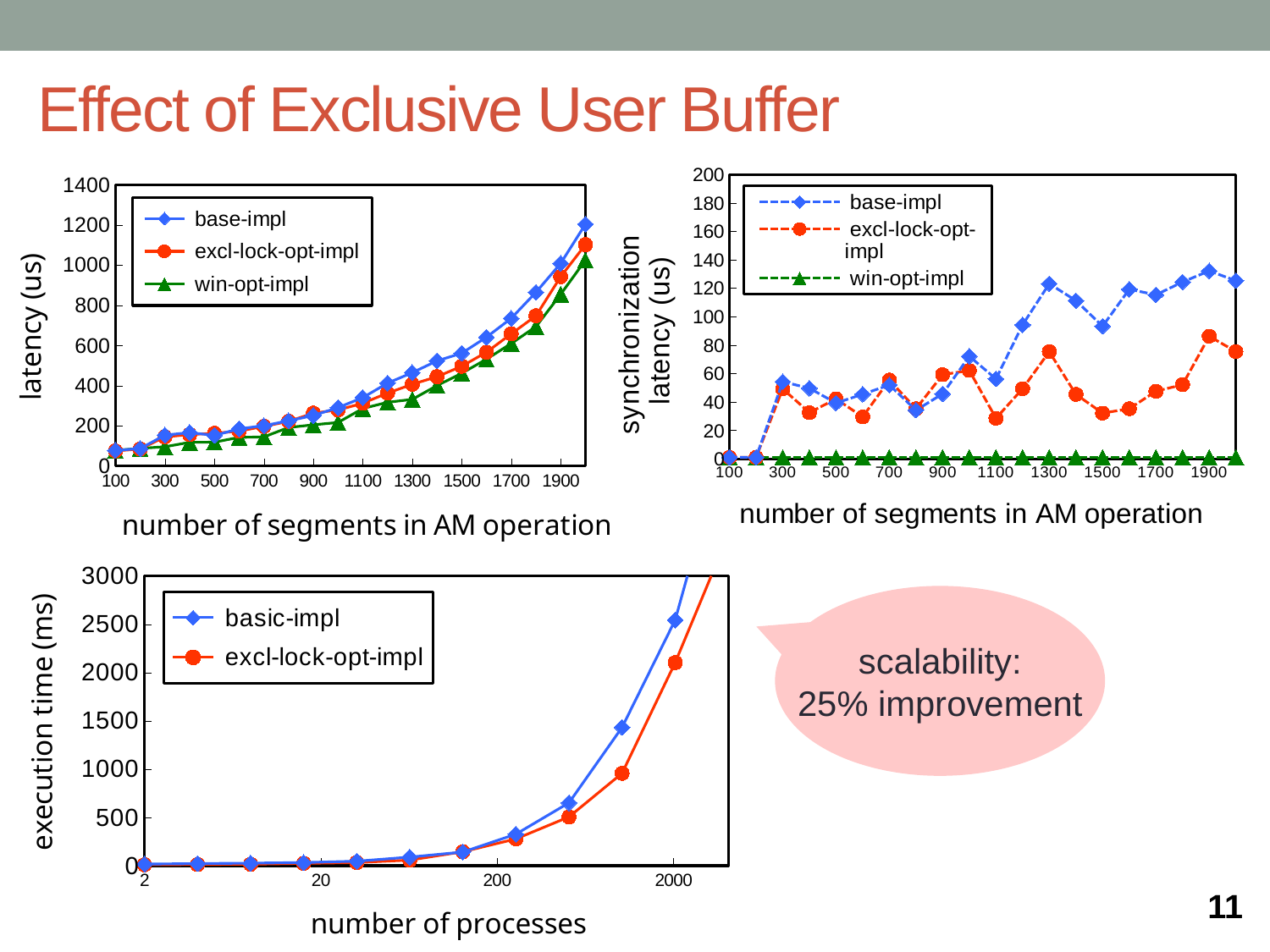
In the top-left chart (latency vs number of segments), do the latency values rise or fall as the number of segments increases? rise In the top-left chart (latency vs number of segments), what kind of chart is shown? line chart In the top-right chart (synchronization latency), which is larger at 1300 segments, base-impl or excl-lock-opt-impl? base-impl In the top-right chart (synchronization latency), which series stays lowest across the whole x axis? win-opt-impl In the top-right chart (synchronization latency), is the value for base-impl at 1900 segments greater or less than 100? greater In the top-left chart (latency vs number of segments), which series has the lowest latency at 1900 segments? win-opt-impl What improvement in scalability does the callout on the slide state? 25% improvement In the top-right chart (synchronization latency), is the value for excl-lock-opt-impl at 1900 segments greater or less than 100? less In the bottom-left chart (execution time vs number of processes), how many series does the legend list? 2 In the bottom-left chart (execution time vs number of processes), is the value for basic-impl at 2000 processes greater or less than 2000? greater In the top-left chart (latency vs number of segments), how many series does the legend list? 3